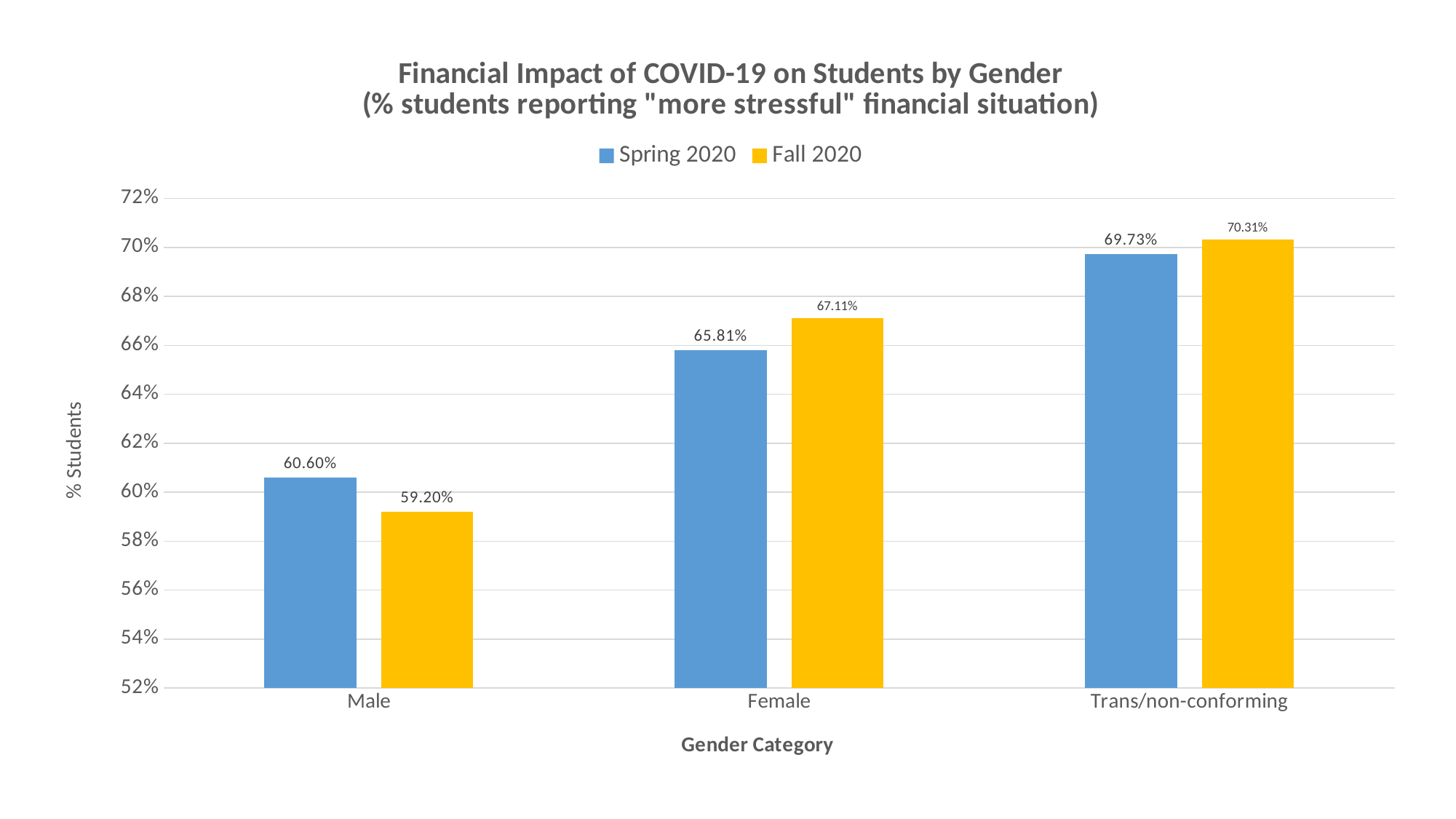
For Male, which is larger: the Spring 2020 value or the Fall 2020 value? Spring 2020 How many series does the legend list? 2 Is the Spring 2020 value for Trans/non-conforming greater or less than 68%? greater How many gender categories are shown on the x axis? 3 What is the Fall 2020 value for Trans/non-conforming? 70.31% What is the difference between the Fall 2020 and Spring 2020 values for Female? 1.30% What is the Spring 2020 value for Male? 60.60% What kind of chart is shown on the slide? Bar chart Which gender category has the lowest Spring 2020 value? Male Which gender category has the highest Fall 2020 value? Trans/non-conforming Which colour represents Fall 2020 in the chart? Yellow What is the Fall 2020 value for Female? 67.11%